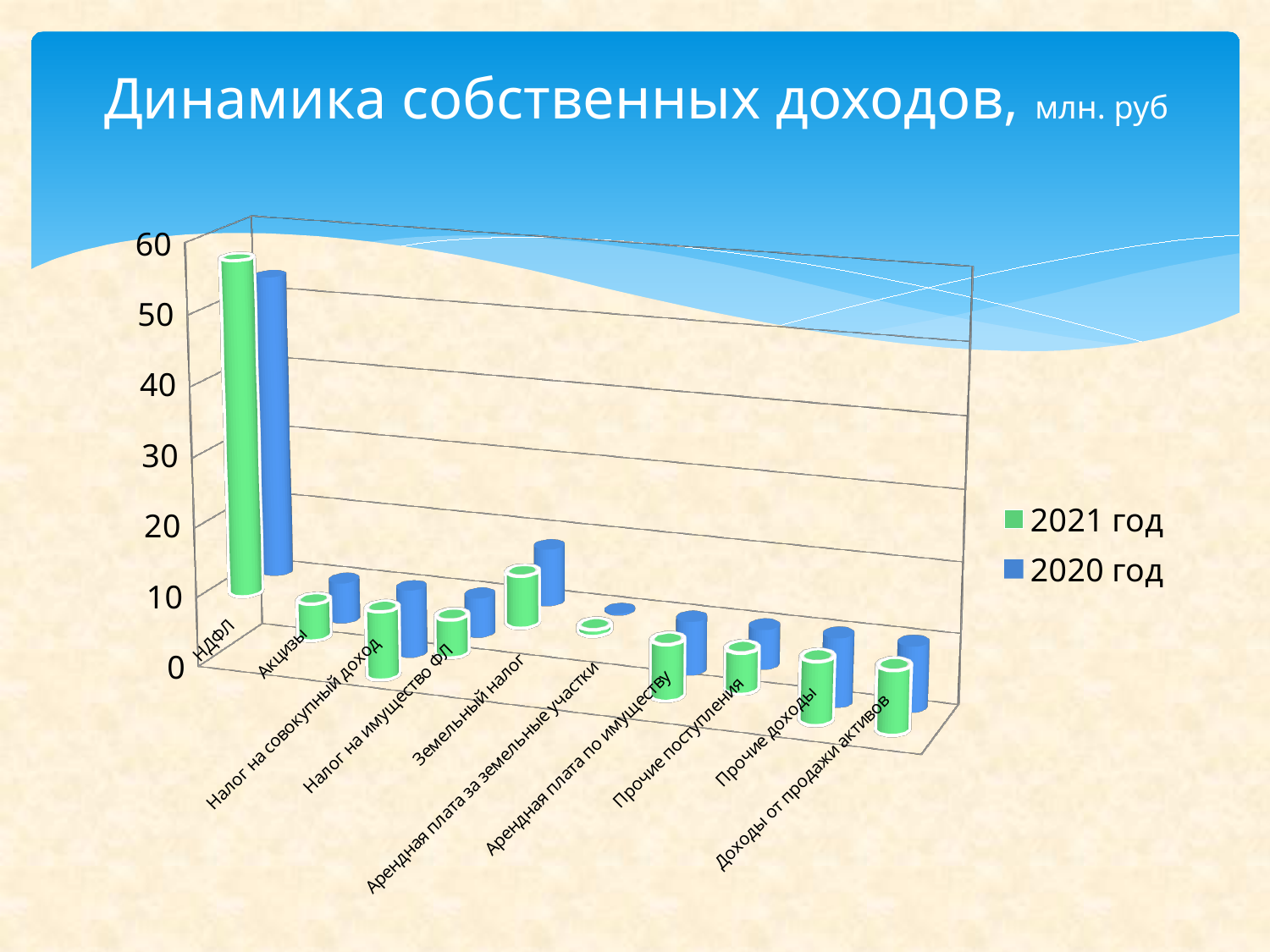
Which is larger, the 2021 год value for НДФЛ or the 2021 год value for Земельный налог? НДФЛ What is the title of the chart on the slide? Динамика собственных доходов, млн. руб Is the 2021 год value for Акцизы greater or less than 20? less What kind of chart is shown on the slide? bar chart Is the 2021 год value for НДФЛ greater or less than 40? greater How many series does the legend list? 2 Which category has the highest value in the chart? НДФЛ Which category has the lowest values in the chart? Арендная плата за земельные участки Which is larger, the 2020 год value for Земельный налог or the 2020 год value for Арендная плата за земельные участки? Земельный налог Which colour represents the 2020 год series in the legend? blue Is the 2020 год value for Арендная плата за земельные участки greater or less than 10? less How many categories are shown on the x axis of the chart? 10